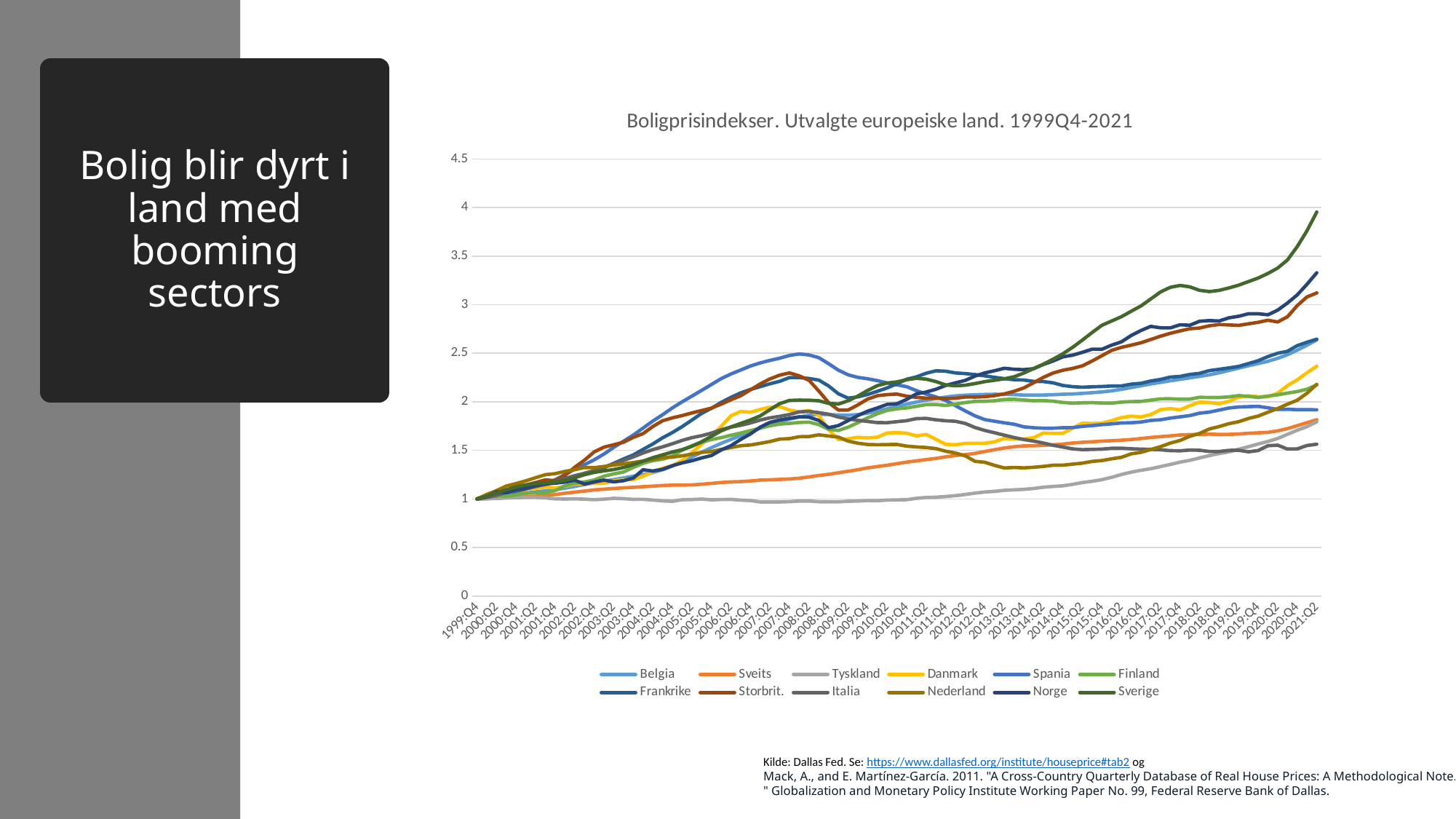
Is the value for Spania at its peak around 2007:Q4 greater or less than 2? greater Is the value for Norge at 2021:Q2 greater or less than 3? greater What is the title of the chart? Boligprisindekser. Utvalgte europeiske land. 1999Q4-2021 Which country has the highest index value at the end of the series (2021:Q2)? Sverige What value do all the series start at in 1999:Q4? 1 At 2021:Q2, which is higher: Sverige or Norge? Sverige Does the Sverige line generally rise or fall from 1999:Q4 to 2021:Q2? rise Is the value for Sverige at 2021:Q2 greater or less than 3.5? greater What kind of chart is shown on the slide? line chart How many series does the legend list? 12 Which country has the lowest index value at the end of the series (2021:Q2)? Italia